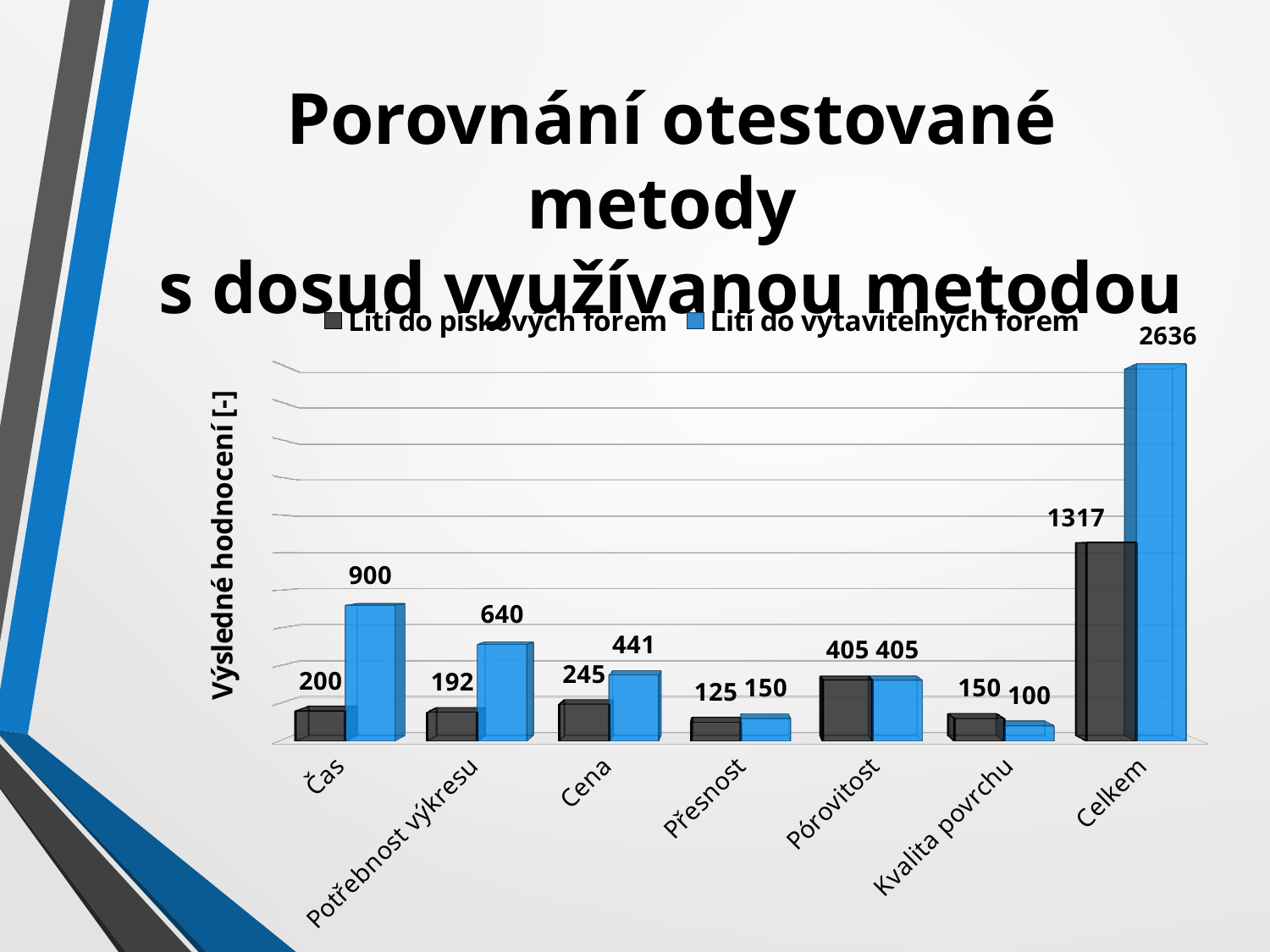
What is the label of the vertical axis? Výsledné hodnocení [-] How many categories are shown on the x axis? 7 Which category has the highest value in the Lití do pískových forem series? Celkem What kind of chart is shown on the slide? Bar chart For Kvalita povrchu, which series has the larger value? Lití do pískových forem What is the value for Čas in the Lití do vytavitelných forem series? 900 What is the value for Potřebnost výkresu in the Lití do pískových forem series? 192 What is the value for Celkem in the Lití do vytavitelných forem series? 2636 What is the difference between the Lití do vytavitelných forem and Lití do pískových forem values for Cena? 196 What is the value for Kvalita povrchu in the Lití do pískových forem series? 150 Which category has the lowest value in the Lití do vytavitelných forem series? Kvalita povrchu How many series does the legend list? 2